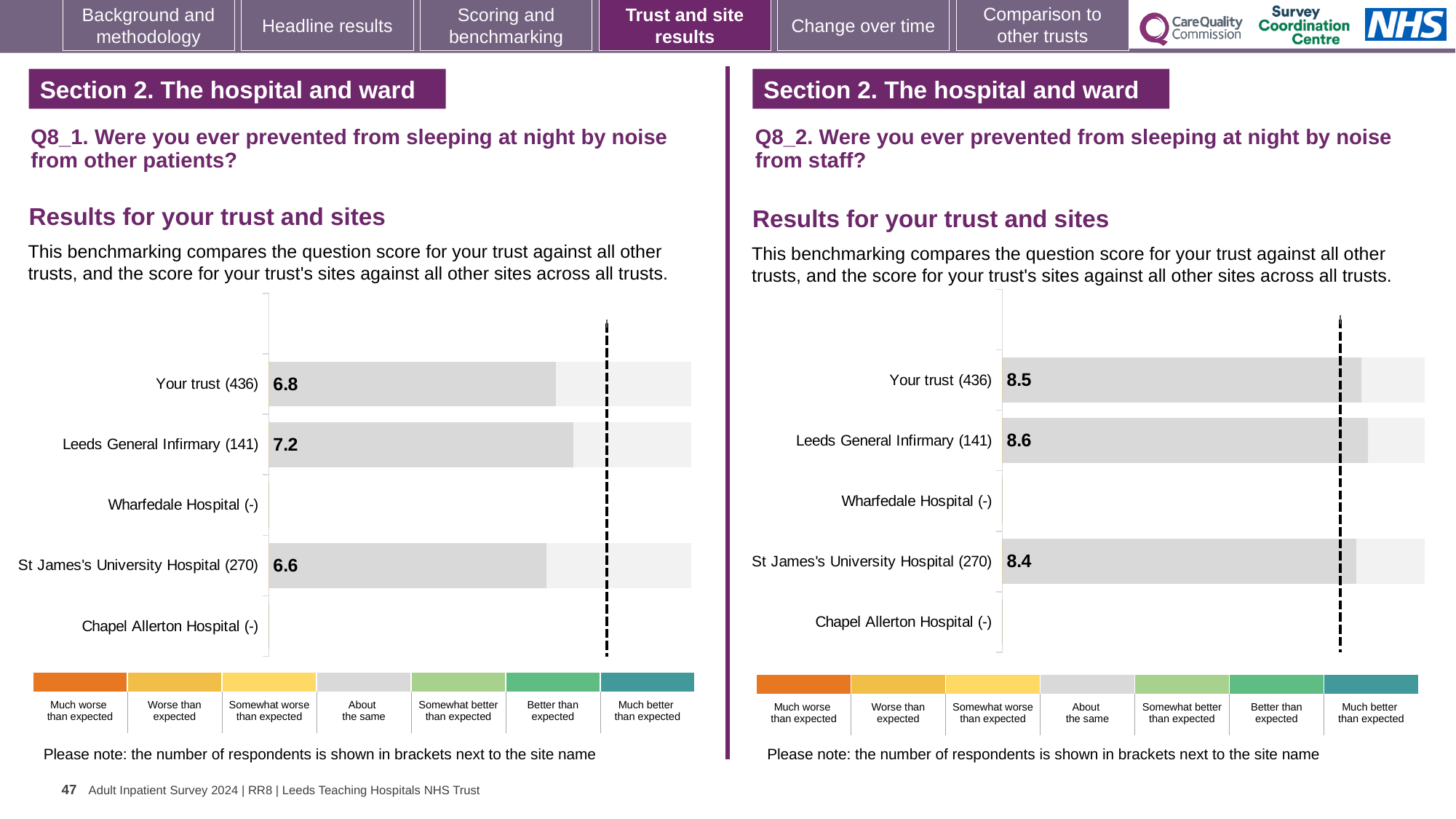
On the Q8_1 chart (noise from other patients), which site or trust row has the highest score? Leeds General Infirmary On the Q8_1 chart (noise from other patients), what is the score for Your trust? 6.8 On the Q8_1 chart (noise from other patients), what is the score for St James's University Hospital? 6.6 What kind of chart is used on the Q8_1 chart (noise from other patients)? Bar chart How many site or trust rows are listed on the Q8_2 chart (noise from staff)? 5 On the Q8_2 chart (noise from staff), what is the score for St James's University Hospital? 8.4 On the Q8_1 chart (noise from other patients), what is the score for Leeds General Infirmary? 7.2 On the Q8_1 chart (noise from other patients), which has the larger score: Your trust or St James's University Hospital? Your trust On the Q8_2 chart (noise from staff), which site or trust row has the lowest score? St James's University Hospital On the Q8_2 chart (noise from staff), what is the score for Your trust? 8.5 On the Q8_2 chart (noise from staff), what is the difference between the Leeds General Infirmary score and the Your trust score? 0.1 On the Q8_1 chart (noise from other patients), what is the difference between the Leeds General Infirmary score and the St James's University Hospital score? 0.6